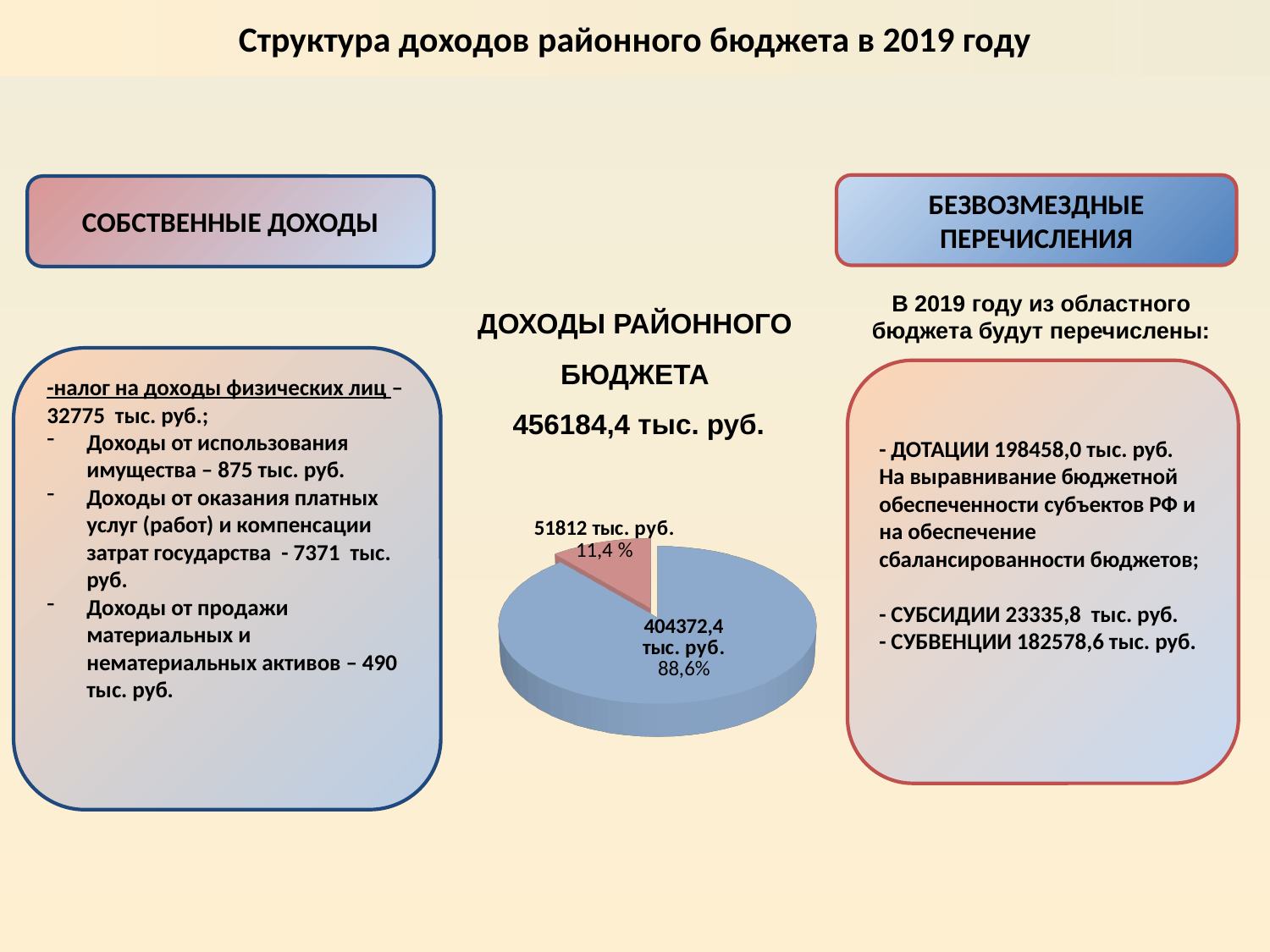
What is the difference between the two slice values in the pie chart (404372,4 and 51812 тыс. руб.)? 352560,4 тыс. руб. What colour is the smaller slice of the pie chart? Pink What is the total of the two slice values in the pie chart? 456184,4 тыс. руб. What value is printed on the large blue slice of the pie chart? 404372,4 тыс. руб. What percentage share does the large blue slice of the pie chart have? 88,6% What percentage share does the small pink slice of the pie chart have? 11,4 % Which is larger in the pie chart: the slice labelled 404372,4 тыс. руб. or the slice labelled 51812 тыс. руб.? 404372,4 тыс. руб. Which slice of the pie chart is the largest? The blue slice (404372,4 тыс. руб.) How many slices does the pie chart have? 2 What kind of chart is shown on the slide? Pie chart Which slice of the pie chart is the smallest? The pink slice (51812 тыс. руб.) What value is printed on the small pink slice of the pie chart? 51812 тыс. руб.